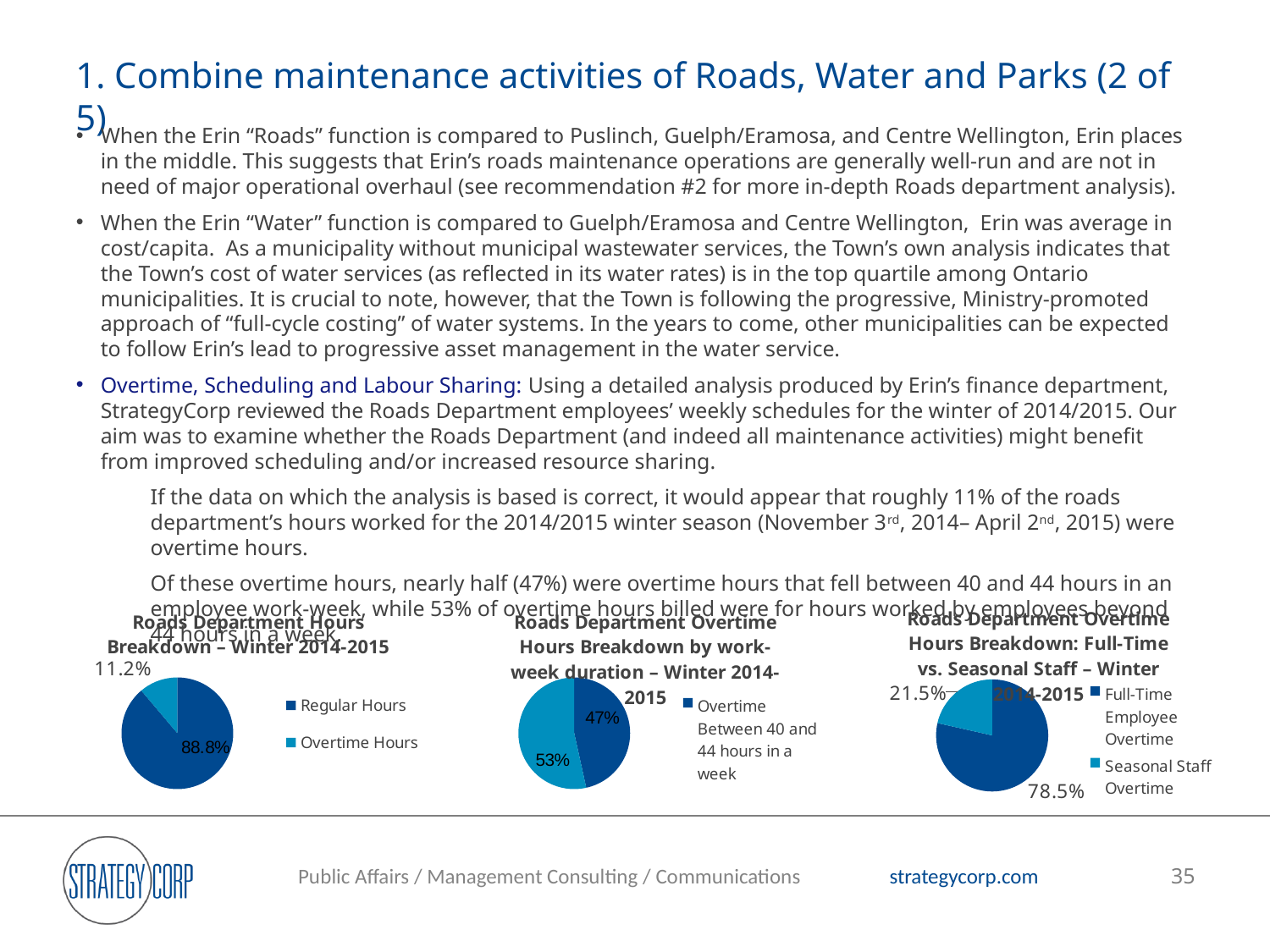
What type of chart is the 'Roads Department Hours Breakdown – Winter 2014-2015' chart? Pie chart In the 'Roads Department Overtime Hours Breakdown: Full-Time vs. Seasonal Staff' chart, what share is Full-Time Employee Overtime? 78.5% In the 'Roads Department Hours Breakdown – Winter 2014-2015' chart, which category has the largest slice? Regular Hours How many entries does the legend of the 'Roads Department Hours Breakdown – Winter 2014-2015' chart list? 2 In the 'Roads Department Hours Breakdown – Winter 2014-2015' chart, what is the difference in percentage points between Regular Hours and Overtime Hours? 77.6 percentage points In the 'Roads Department Hours Breakdown – Winter 2014-2015' chart, what share of hours is Regular Hours? 88.8% In the 'Roads Department Overtime Hours Breakdown: Full-Time vs. Seasonal Staff' chart, what share is Seasonal Staff Overtime? 21.5% In the 'Roads Department Overtime Hours Breakdown: Full-Time vs. Seasonal Staff' chart, which category has the smaller slice? Seasonal Staff Overtime In the middle chart, 'Roads Department Overtime Hours Breakdown by work-week duration', what share is labelled for Overtime Between 40 and 44 hours in a week? 47% In the 'Roads Department Hours Breakdown – Winter 2014-2015' chart, what share of hours is Overtime Hours? 11.2% In the middle chart, 'Roads Department Overtime Hours Breakdown by work-week duration', what is the larger of the two slice values shown? 53% How many pie charts are shown on the slide? 3